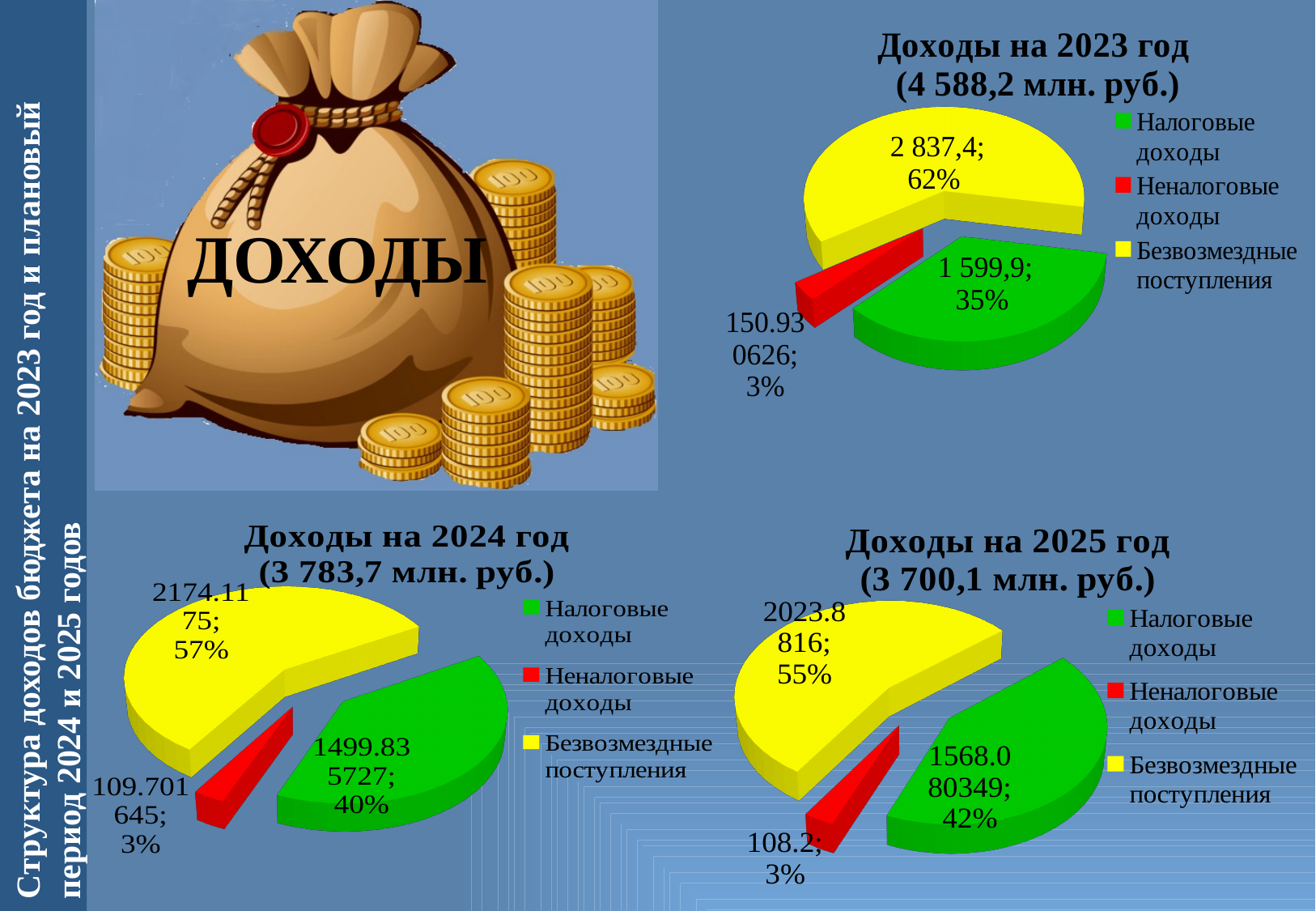
In the chart 'Доходы на 2024 год', what is the value for Неналоговые доходы? 109.701645 In the chart 'Доходы на 2023 год', which category has the smallest slice? Неналоговые доходы How many categories does the legend of the chart 'Доходы на 2024 год' list? 3 In the chart 'Доходы на 2025 год', what colour represents Неналоговые доходы? Red What kind of chart is 'Доходы на 2023 год'? Pie chart In the chart 'Доходы на 2025 год', what is the value for Неналоговые доходы? 108.2 In the chart 'Доходы на 2023 год', what share of the pie is Безвозмездные поступления? 62% In the chart 'Доходы на 2024 год', what share of the pie is Налоговые доходы? 40% In the chart 'Доходы на 2025 год', what share of the pie is Безвозмездные поступления? 55% In the chart 'Доходы на 2024 год', which category has the largest slice? Безвозмездные поступления In the chart 'Доходы на 2023 год', what is the value for Налоговые доходы? 1 599,9 In the chart 'Доходы на 2025 год', which is larger: Налоговые доходы or Безвозмездные поступления? Безвозмездные поступления